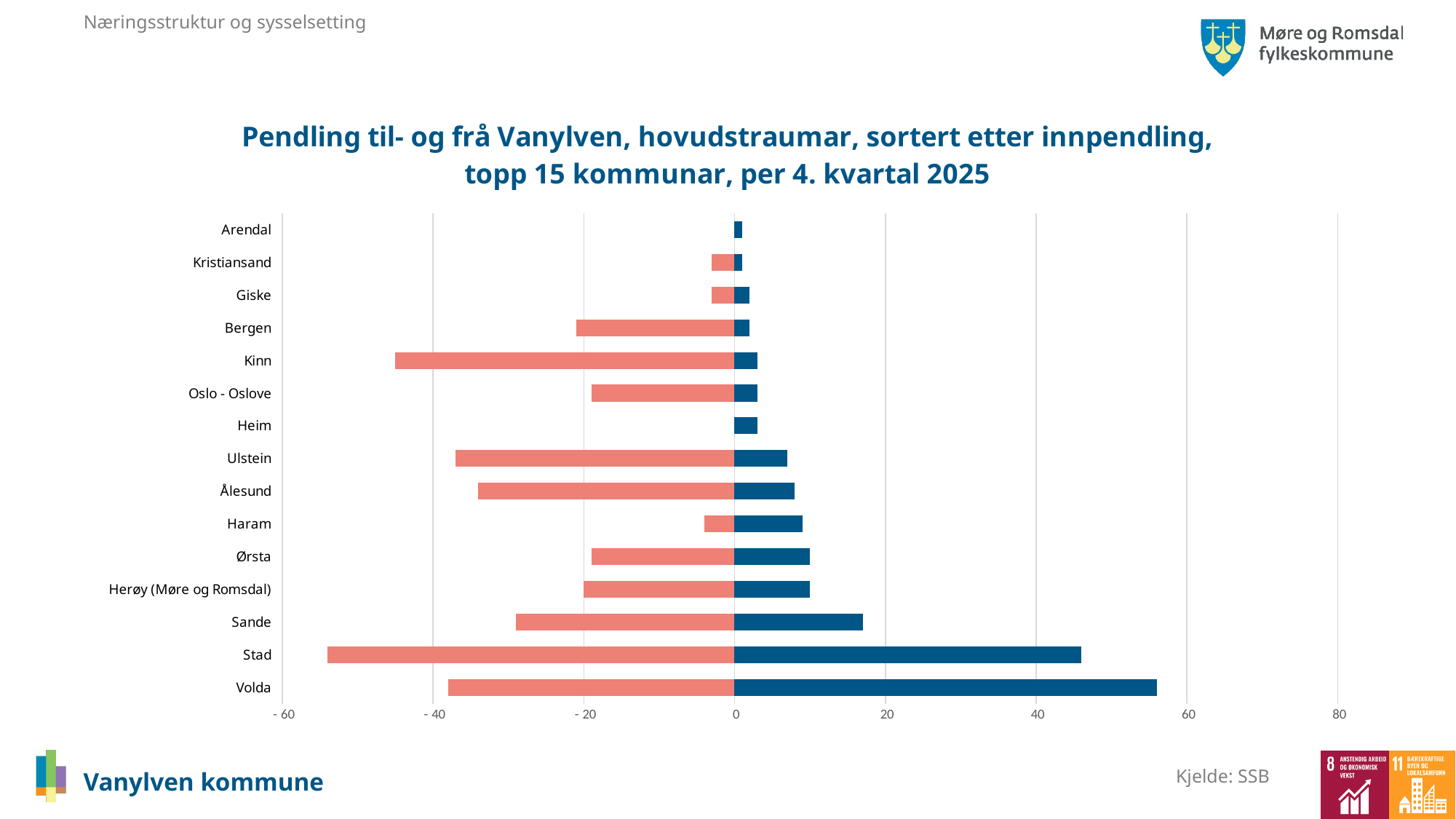
Which has the longer red (negative) bar, Kinn or Bergen? Kinn Is the blue (positive) value for Sande greater or less than 20? less How many municipalities (categories) are listed on the vertical axis of the chart? 15 Is the red (negative) value for Kinn greater or less than -40? less What kind of chart is shown on the slide? bar chart Is the blue (positive) value for Volda greater or less than 40? greater Which has the larger blue (positive) bar, Volda or Stad? Volda Which municipality has the longest red (negative) bar in the chart? Stad What source is cited for the chart data on the slide? SSB Which municipality has the longest blue (positive) bar in the chart? Volda Which has the larger blue (positive) bar, Sande or Haram? Sande